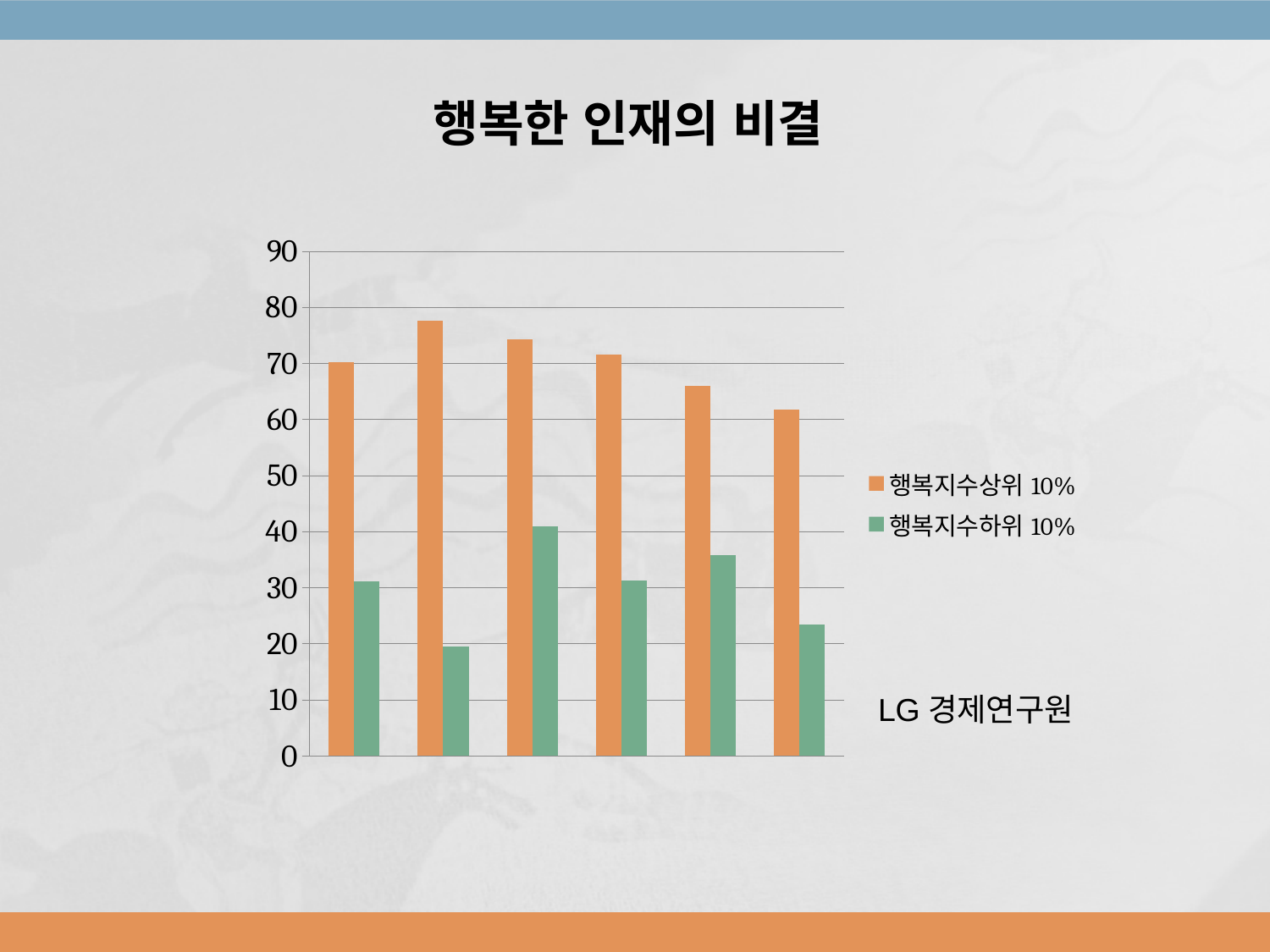
Is the 행복지수상위 10% value in the second group from the left greater or less than 70? greater How many groups of bars are plotted along the x axis? 6 What kind of chart is shown on the slide? bar chart Is the 행복지수상위 10% value in the sixth group from the left greater or less than 70? less What is the title shown above the chart? 행복한 인재의 비결 What are the two legend entries of the chart? 행복지수상위 10%, 행복지수하위 10% How many series does the legend list? 2 Counting from the left, which group of bars has the tallest 행복지수상위 10% bar? the second group Counting from the left, which group of bars has the shortest 행복지수하위 10% bar? the second group Is the 행복지수하위 10% value in the fifth group from the left greater or less than 30? greater Which series has the higher value in every group of bars? 행복지수상위 10% Counting from the left, which group of bars has the tallest 행복지수하위 10% bar? the third group